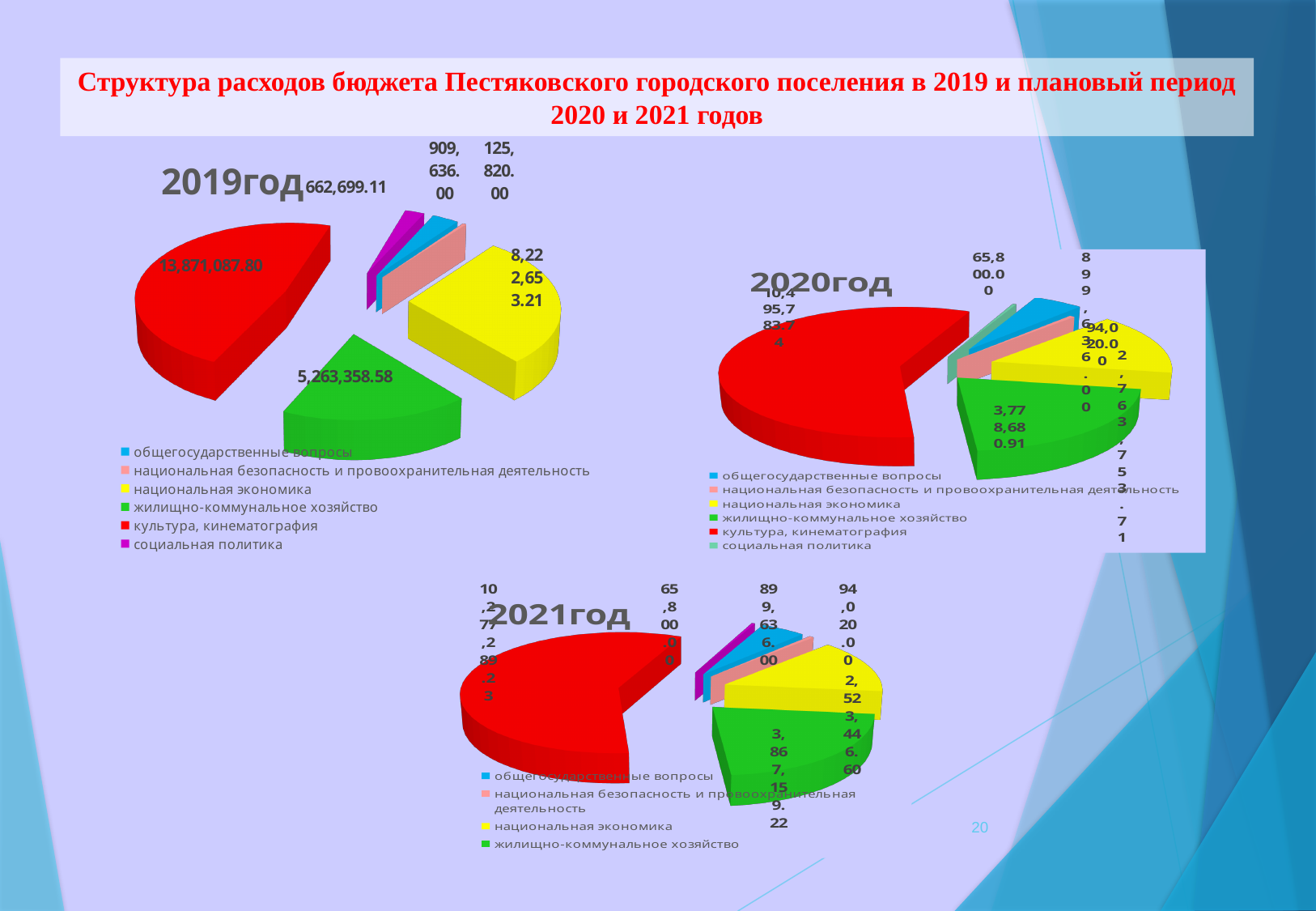
In the 2019год chart, which is larger: национальная экономика or жилищно-коммунальное хозяйство? национальная экономика In the 2019год chart, what is the value for национальная экономика? 8,222,653.21 In the 2019год chart, which category has the largest slice? культура, кинематография What kind of charts are shown on the slide? Pie charts In the 2019год chart, what is the difference between культура, кинематография and жилищно-коммунальное хозяйство? 8,607,729.22 In the 2019год chart, what is the value for жилищно-коммунальное хозяйство? 5,263,358.58 In the 2020год chart, what is the value for жилищно-коммунальное хозяйство? 3,778,680.91 In the 2021год chart, which category has the largest slice? культура, кинематография In the 2019год chart, which colour represents национальная экономика? Yellow How many pie charts are on the slide? 3 How many entries does the legend of the 2019год chart list? 6 In the 2019год chart, what is the value for культура, кинематография? 13,871,087.80